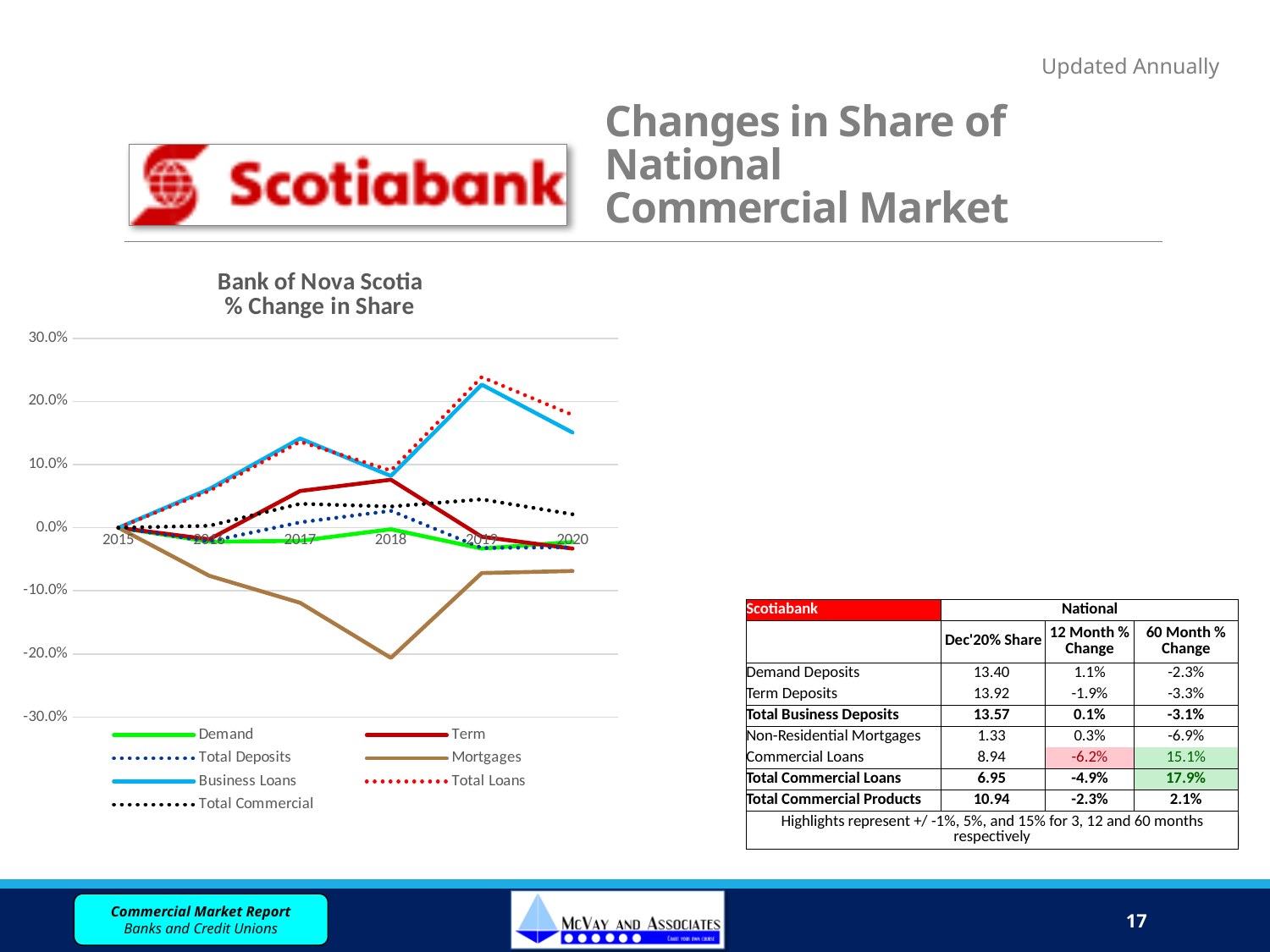
Is the value for Business Loans in 2019 greater or less than 20.0%? greater Which series has the lowest value in 2018? Mortgages Which series reaches the lowest value anywhere on the chart? Mortgages Is the value for Mortgages in 2018 greater or less than -10.0%? less Is the value for Term in 2018 greater or less than 10.0%? less What is the title of the chart? Bank of Nova Scotia % Change in Share Which is larger in 2020, the value for Business Loans or the value for Mortgages? Business Loans How many years are plotted along the x axis of the chart? 6 What kind of chart is shown on the slide? line chart How many series does the chart legend list? 7 Do the values for Mortgages rise or fall from 2015 to 2018? fall Which is larger in 2017, the value for Term or the value for Demand? Term